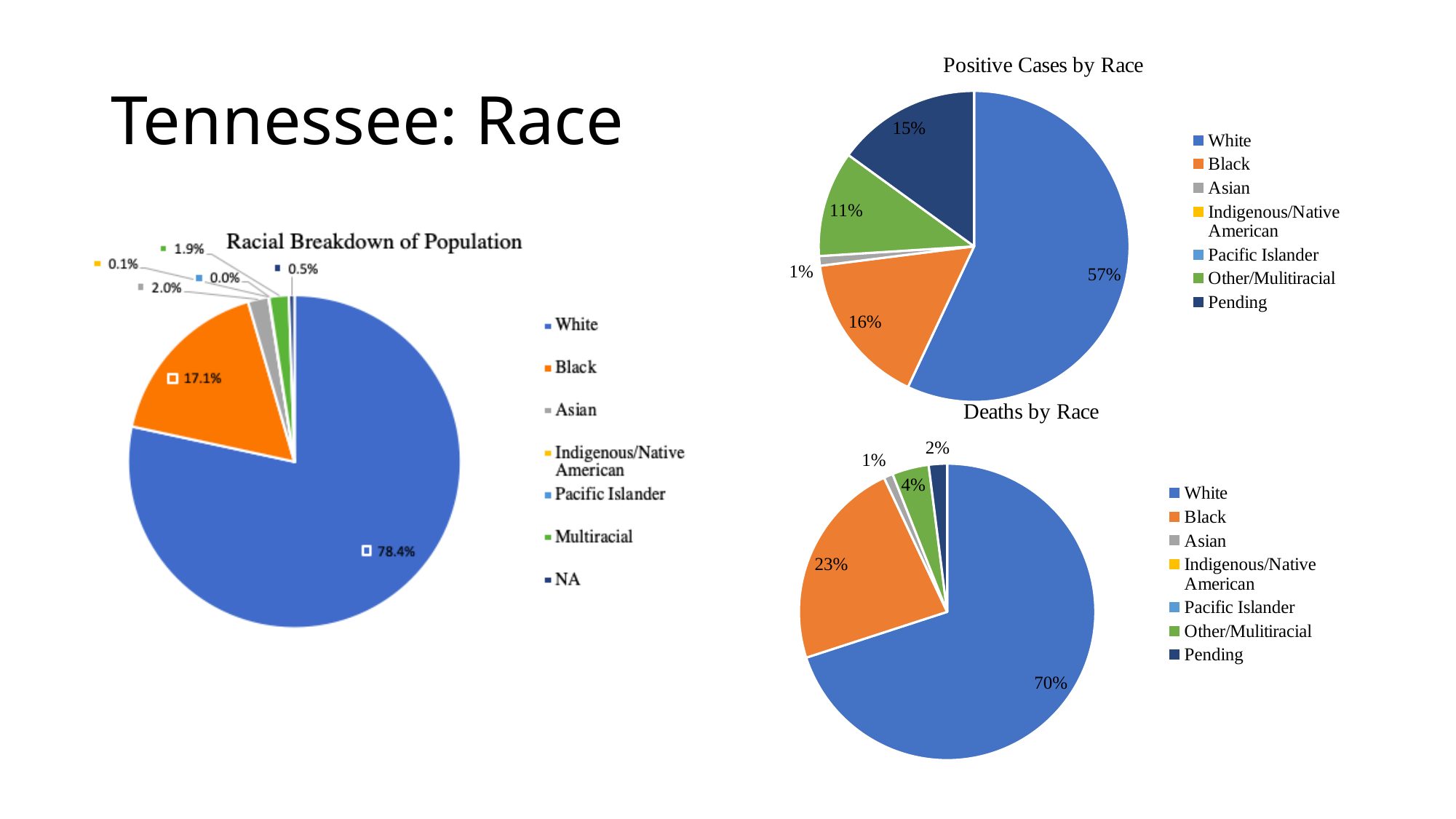
In the 'Deaths by Race' chart, what is the difference between the White share and the Black share? 47% In the 'Deaths by Race' chart, what percentage of deaths is White? 70% In the 'Positive Cases by Race' chart, what percentage of positive cases is Pending? 15% In the 'Positive Cases by Race' chart, which is larger, the Black share or the Pending share? Black What kind of chart is 'Positive Cases by Race'? Pie chart In the 'Deaths by Race' chart, what percentage of deaths is Other/Mulitiracial? 4% How many entries does the legend of the 'Deaths by Race' chart list? 7 In the 'Racial Breakdown of Population' chart, what share of the population is White? 78.4% In the 'Racial Breakdown of Population' chart, what share of the population is Black? 17.1% In the 'Positive Cases by Race' chart, what percentage of positive cases is Black? 16% In the 'Racial Breakdown of Population' chart, what is the difference between the Asian share and the Multiracial share? 0.1% In the 'Deaths by Race' chart, which category has the largest share? White